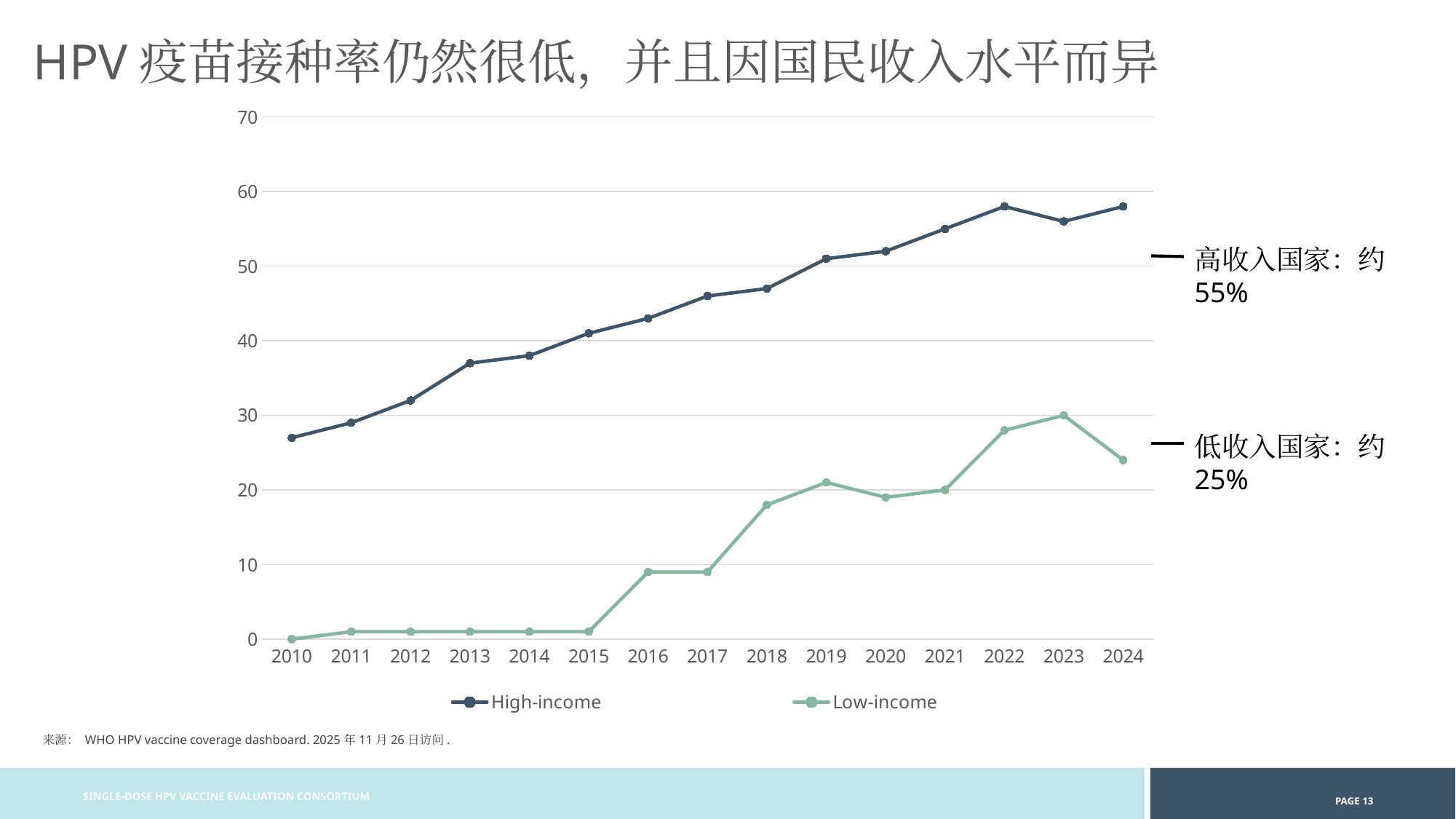
What is the Low-income value in 2010? 0 What kind of chart is shown on the slide? line chart How many years are plotted along the x axis? 15 Is the Low-income value for 2016 greater or less than 10? less How many series does the legend list? 2 In which year is the High-income series lowest? 2010 In which year is the Low-income series highest? 2023 In 2020, which series has the larger value, High-income or Low-income? High-income Is the High-income value for 2013 greater or less than 40? less What is the Low-income value in 2023? 30 Is the High-income value for 2024 greater or less than 50? greater Does the High-income series generally rise or fall from 2010 to 2024? rise